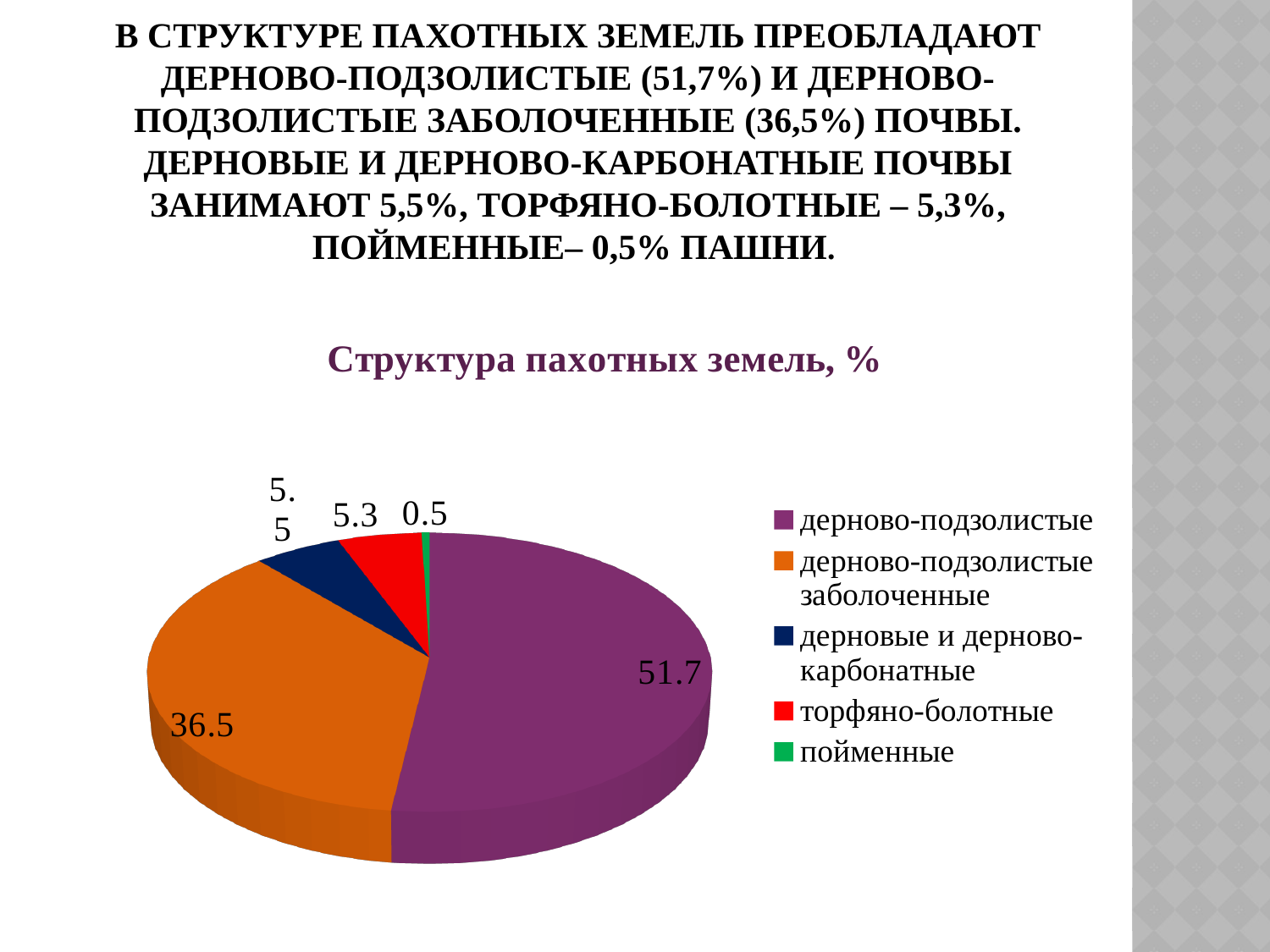
What is the value for пойменные in the chart? 0.5 How many categories does the legend list? 5 Which category has the smallest slice of the pie? пойменные What is the title of the chart? Структура пахотных земель, % What is the value for дерновые и дерново-карбонатные in the chart? 5.5 What is the value for дерново-подзолистые заболоченные in the chart? 36.5 Which category has the largest slice of the pie? дерново-подзолистые What type of chart is shown on the slide? pie chart What is the value for торфяно-болотные in the chart? 5.3 Which is larger: дерново-подзолистые заболоченные or дерново-подзолистые? дерново-подзолистые What is the difference between the values for дерново-подзолистые and дерново-подзолистые заболоченные? 15.2 What is the value for дерново-подзолистые in the chart? 51.7